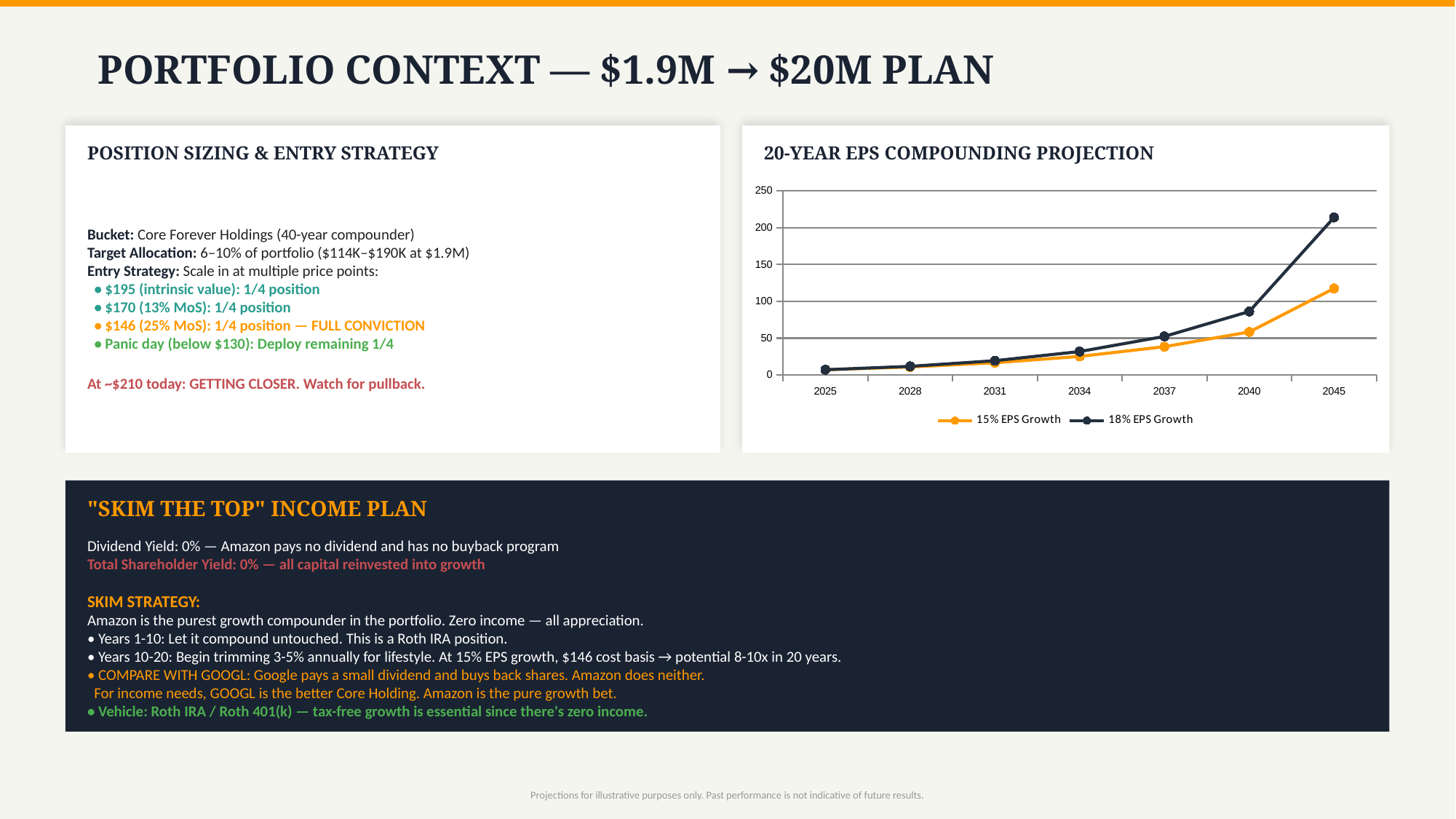
How many series does the legend of the 20-Year EPS Compounding Projection chart list? 2 In the 20-Year EPS Compounding Projection chart, which year has the lowest value for 18% EPS Growth? 2025 In the 20-Year EPS Compounding Projection chart, is the value for 15% EPS Growth in 2045 greater or less than 100? greater In the 20-Year EPS Compounding Projection chart, do the values for 18% EPS Growth rise or fall from 2025 to 2045? Rise In the 20-Year EPS Compounding Projection chart, is the value for 18% EPS Growth in 2040 greater or less than 100? less In the 20-Year EPS Compounding Projection chart, is the value for 18% EPS Growth in 2045 greater or less than 200? greater In the 20-Year EPS Compounding Projection chart, which year has the highest value for 15% EPS Growth? 2045 In the 20-Year EPS Compounding Projection chart, which series has the larger value in 2045, 15% EPS Growth or 18% EPS Growth? 18% EPS Growth How many years are marked on the x axis of the 20-Year EPS Compounding Projection chart? 7 What kind of chart is the 20-Year EPS Compounding Projection? Line chart What colour is the line for 15% EPS Growth in the 20-Year EPS Compounding Projection chart? Orange